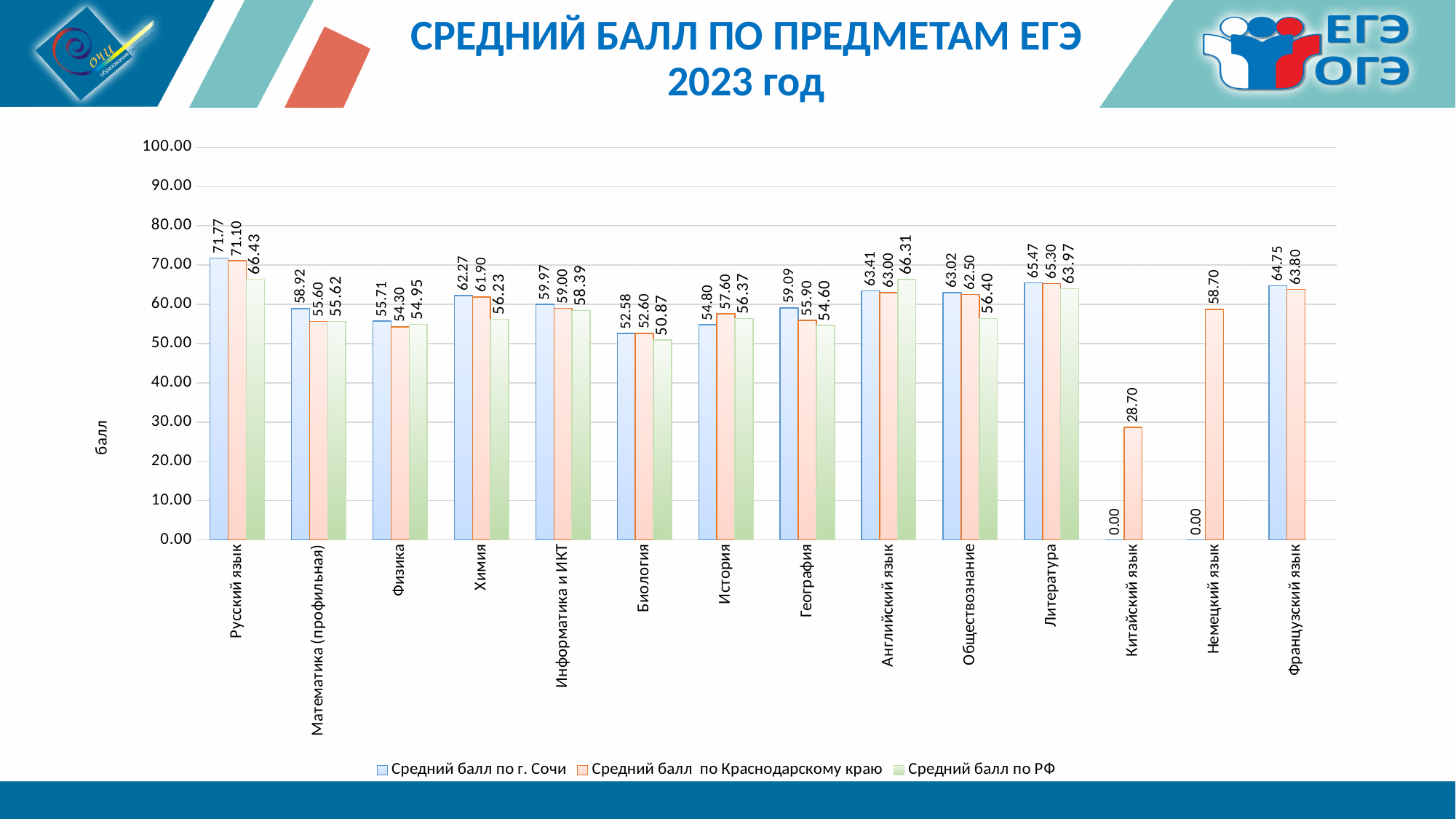
What is the value for Английский язык in the series Средний балл по РФ? 66.31 What is the label of the vertical axis? балл For История, which is larger: the Средний балл по г. Сочи value or the Средний балл по Краснодарскому краю value? Средний балл по Краснодарскому краю Which subject has the highest value in the series Средний балл по г. Сочи? Русский язык How many subjects are shown on the x axis of the chart? 14 For Обществознание, what is the difference between the Средний балл по г. Сочи value and the Средний балл по РФ value? 6.62 For Русский язык, what is the difference between the Средний балл по г. Сочи value and the Средний балл по Краснодарскому краю value? 0.67 What is the average score for Русский язык in the series Средний балл по г. Сочи? 71.77 Which subject has the lowest value in the series Средний балл по РФ? Биология What kind of chart is shown on the slide? Bar chart What is the average score for Китайский язык in the series Средний балл по Краснодарскому краю? 28.70 How many series does the legend list? 3